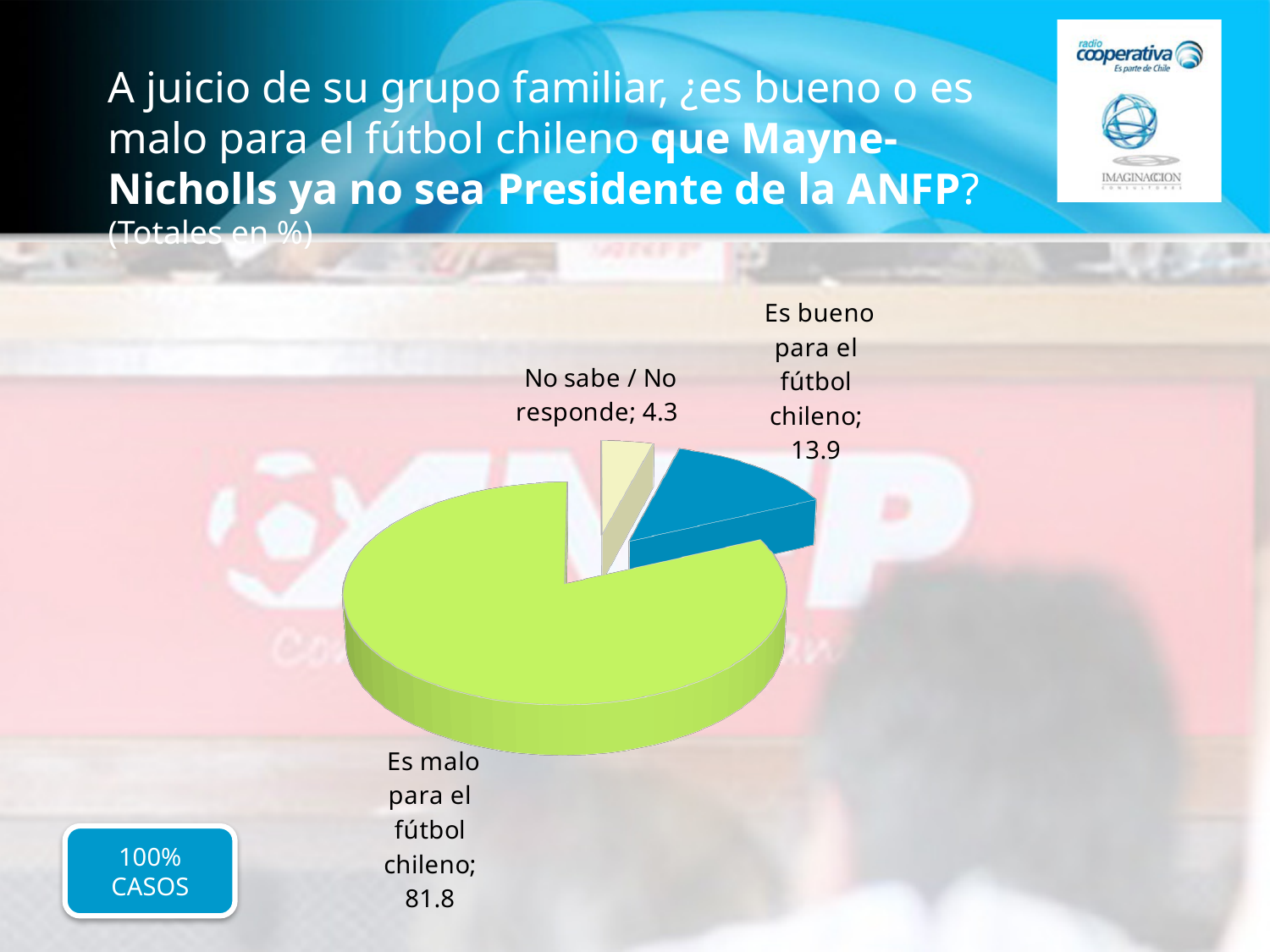
What is the difference between the values for "Es malo para el fútbol chileno" and "Es bueno para el fútbol chileno"? 67.9 What colour is the slice for "Es bueno para el fútbol chileno"? Blue Which is larger, the value for "Es bueno para el fútbol chileno" or the value for "No sabe / No responde"? Es bueno para el fútbol chileno What is the value for "Es bueno para el fútbol chileno"? 13.9 Which category has the smallest slice of the pie? No sabe / No responde Which category has the largest slice of the pie? Es malo para el fútbol chileno What is the value for "No sabe / No responde"? 4.3 How many slices does the pie chart have? 3 What is the value for "Es malo para el fútbol chileno"? 81.8 What type of chart is shown on the slide? Pie chart What colour is the slice for "Es malo para el fútbol chileno"? Green What is the difference between the values for "Es bueno para el fútbol chileno" and "No sabe / No responde"? 9.6